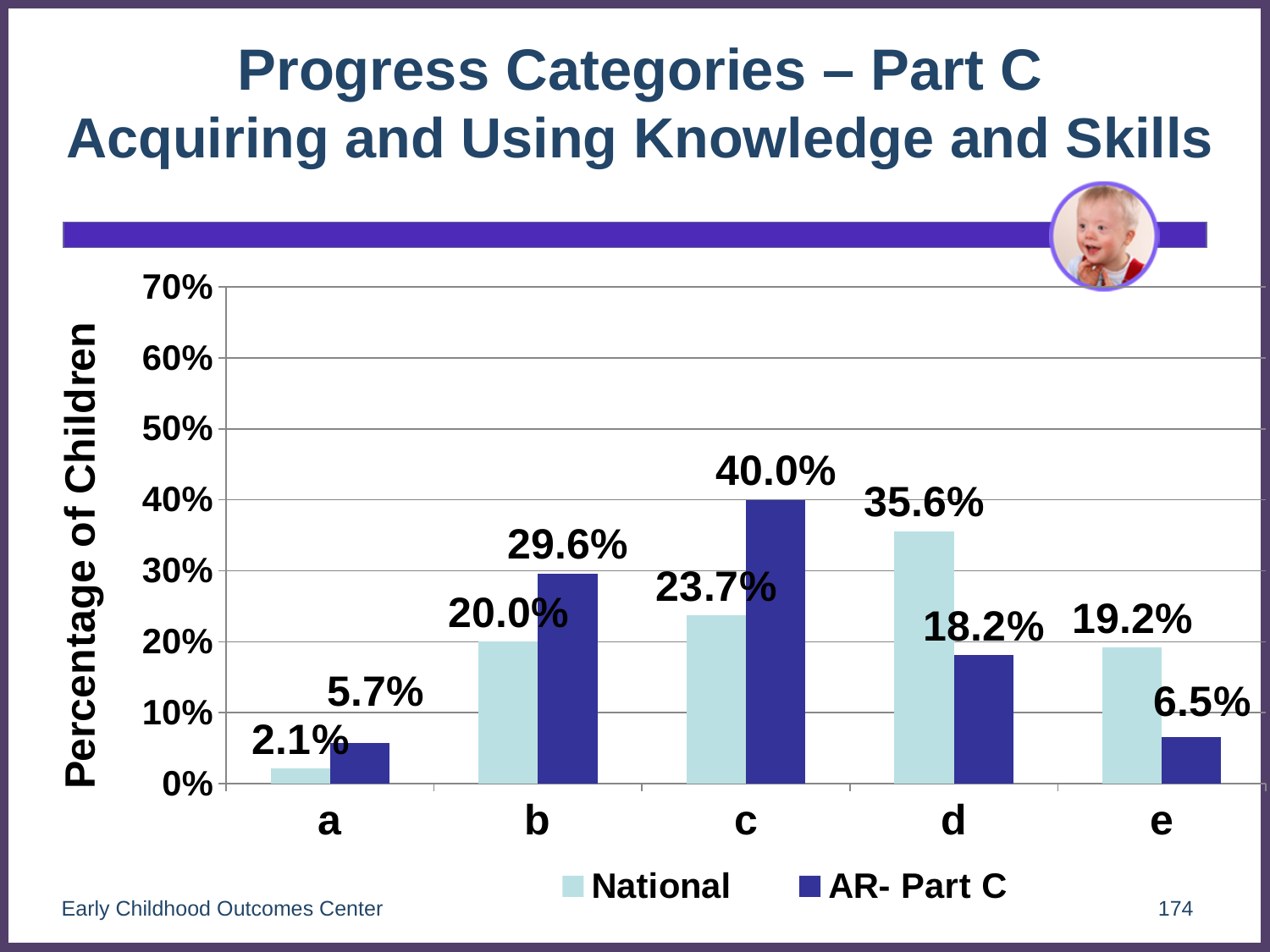
How many categories are shown on the x axis? 5 Is the AR- Part C value for category c greater or less than 30%? greater What is the difference between the National and AR- Part C values for category d? 17.4% Which is larger for category b, the National value or the AR- Part C value? AR- Part C What is the AR- Part C value for category b? 29.6% What is the label of the y axis? Percentage of Children Which category has the lowest National value? a Which category has the highest AR- Part C value? c What is the National value for category c? 23.7% What kind of chart is shown on the slide? bar chart How many series does the legend list? 2 What is the AR- Part C value for category e? 6.5%